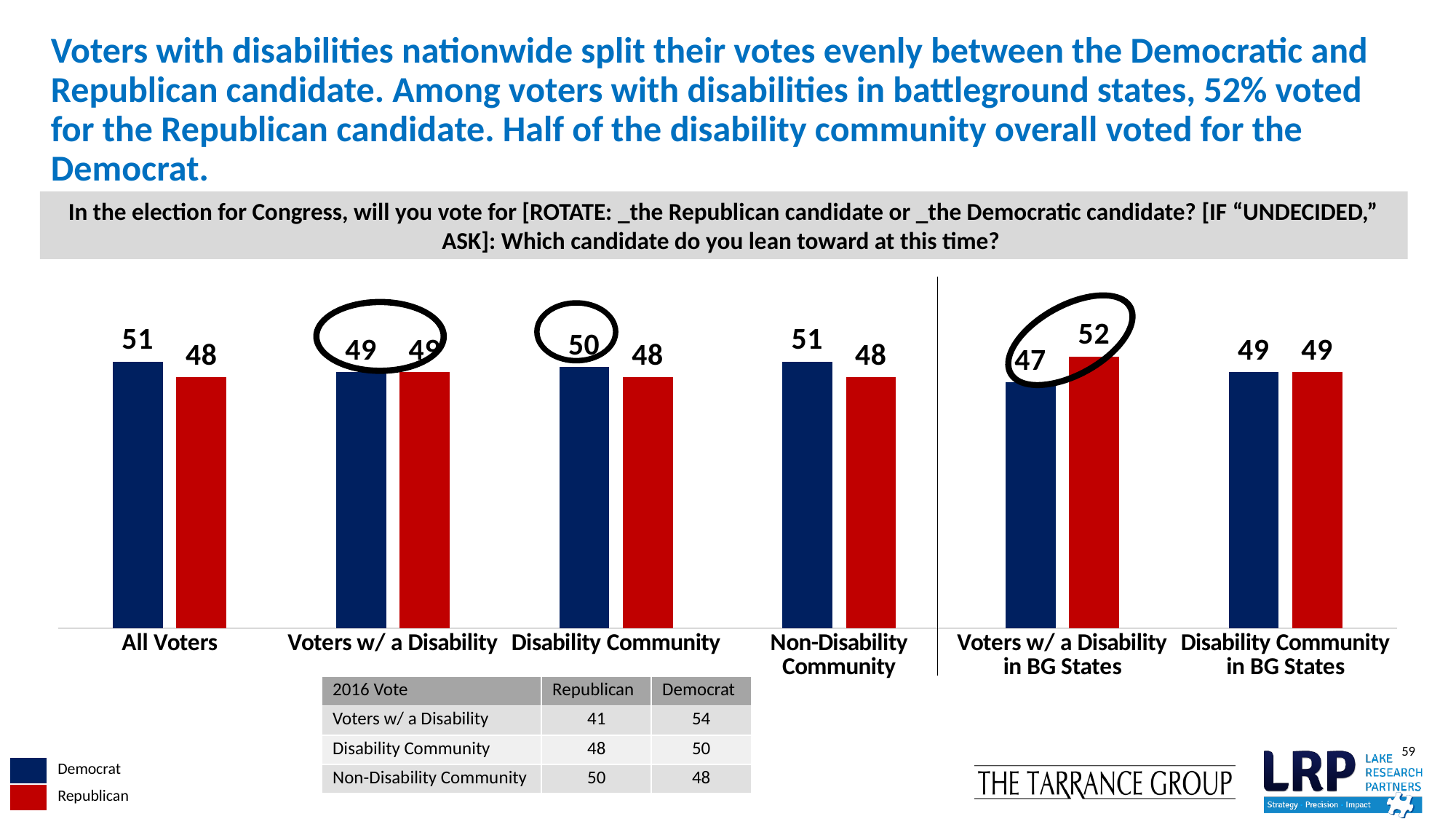
How many series does the legend list? 2 Which colour represents Republican in the chart? Red What is the difference between the Democrat and Republican values for Voters w/ a Disability in BG States? 5 Which category has the lowest Democrat value? Voters w/ a Disability in BG States How many categories are shown on the x axis of the chart? 6 What is the Republican value for Non-Disability Community? 48 What is the Democrat value for Disability Community? 50 What kind of chart is shown on the slide? Bar chart Which category has the highest Republican value? Voters w/ a Disability in BG States What is the Democrat value for All Voters? 51 For All Voters, which is larger, the Democrat value or the Republican value? Democrat What is the Republican value for Voters w/ a Disability in BG States? 52